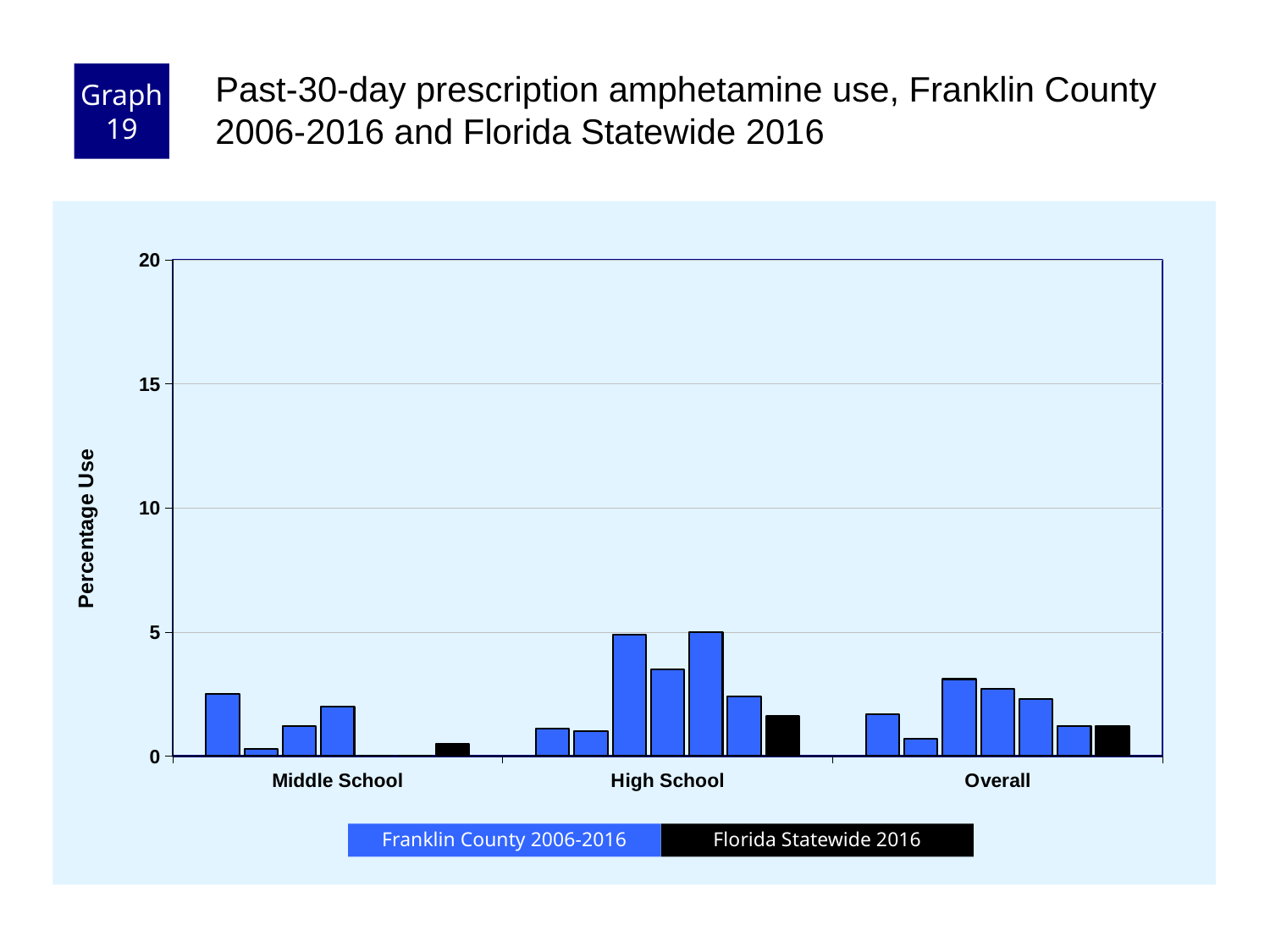
Which is larger, the Florida Statewide 2016 value for Overall or for Middle School? Overall Which is larger, the Florida Statewide 2016 value for High School or for Middle School? High School What is the label of the y axis? Percentage Use How many series does the legend list? 2 Which category contains the tallest bar in the chart? High School Which category has the lowest Florida Statewide 2016 value? Middle School Is the Florida Statewide 2016 value for Overall greater or less than 5? less What is the highest value shown on the y axis? 20 Is the Florida Statewide 2016 value for Middle School greater or less than 5? less Is the Florida Statewide 2016 value for High School greater or less than 5? less What kind of chart is shown on the slide? bar chart How many school-level categories are shown on the x axis? 3